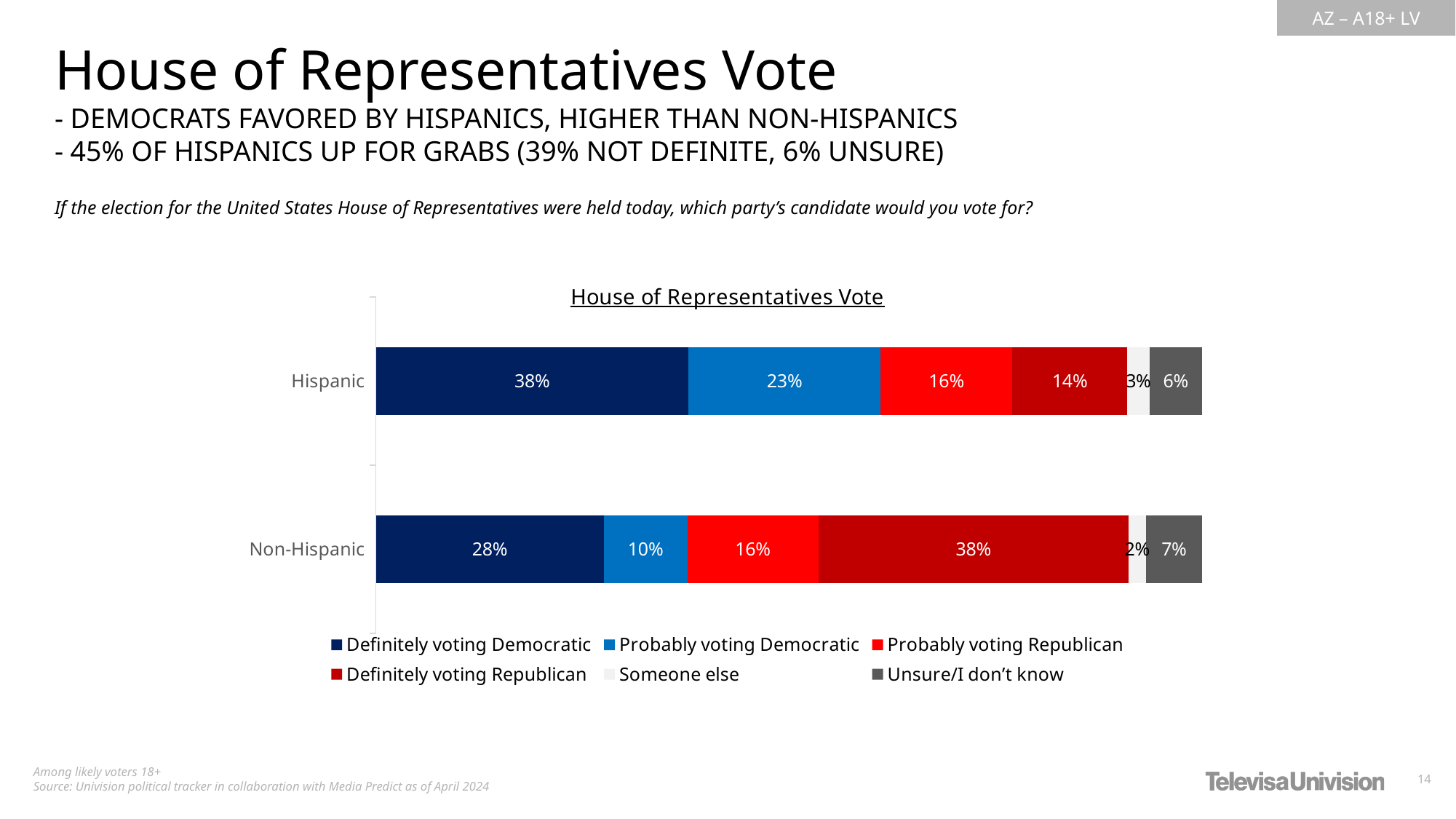
What percentage of Non-Hispanic likely voters are probably voting Democratic? 10% How many series does the legend list? 6 Which response category has the largest share among Hispanic likely voters? Definitely voting Democratic What is the difference between the Hispanic and Non-Hispanic shares for 'Probably voting Democratic'? 13% What percentage of Non-Hispanic likely voters are definitely voting Republican? 38% What is the combined share of Hispanic likely voters who are definitely or probably voting Democratic? 61% How many groups (bars) are shown in the chart? 2 What type of chart is shown on the slide? Stacked bar chart Which response category has the smallest share among Non-Hispanic likely voters? Someone else What percentage of Hispanic likely voters are unsure/don't know? 6% Which group has a larger share for 'Definitely voting Republican', Hispanic or Non-Hispanic? Non-Hispanic What percentage of Hispanic likely voters are definitely voting Democratic? 38%